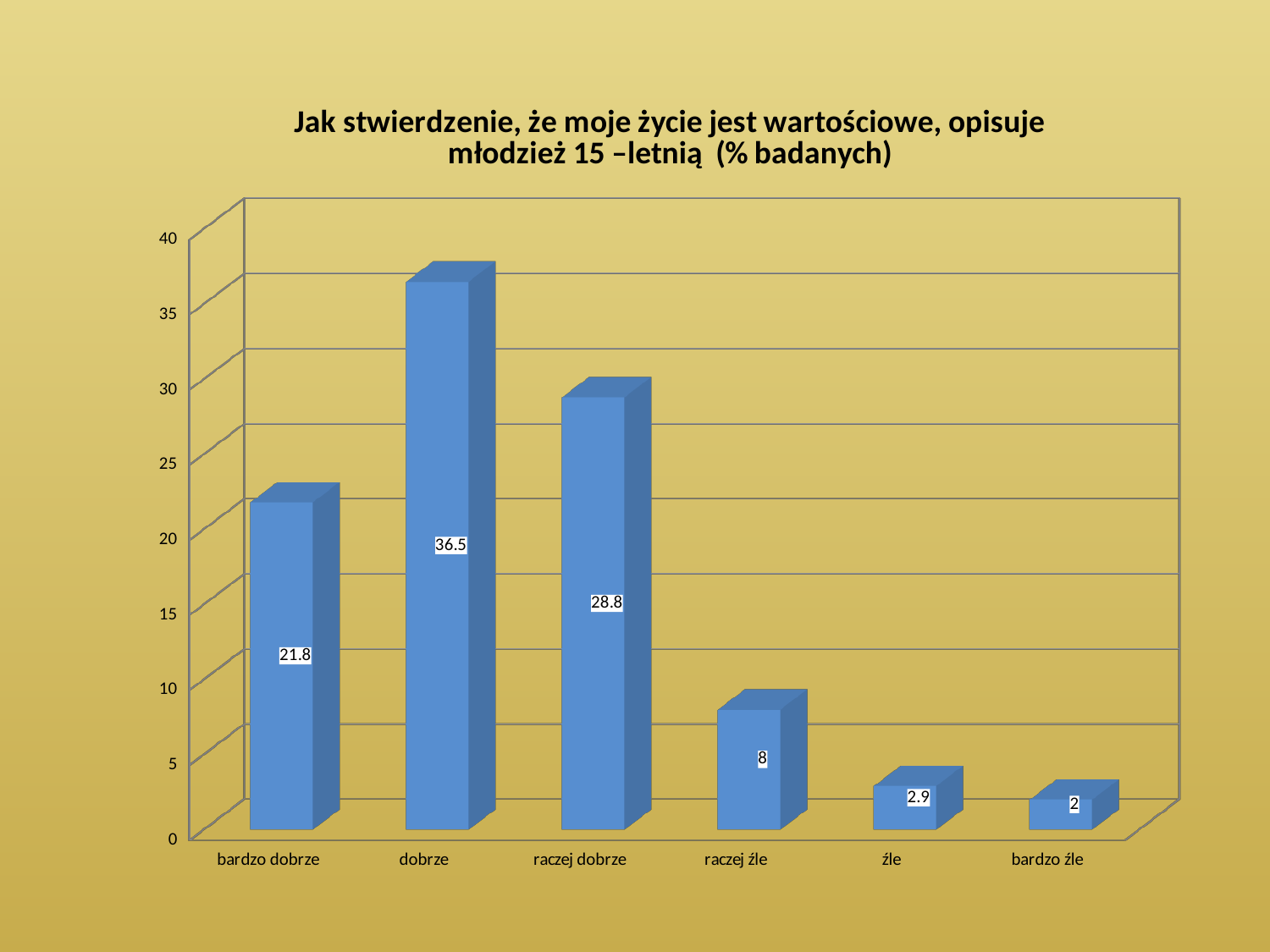
What is the value for "raczej źle"? 8 Which category has the highest value? dobrze Is the value for "źle" greater or less than 5? less How many categories are shown on the x axis? 6 Which category has the lowest value? bardzo źle What is the value for "bardzo dobrze"? 21.8 What is the title of the chart? Jak stwierdzenie, że moje życie jest wartościowe, opisuje młodzież 15 –letnią (% badanych) What is the value for "bardzo źle"? 2 What is the value for "dobrze"? 36.5 What is the difference between the values for "dobrze" and "raczej dobrze"? 7.7 What kind of chart is shown on the slide? bar chart Which is larger, the value for "bardzo dobrze" or the value for "raczej dobrze"? raczej dobrze